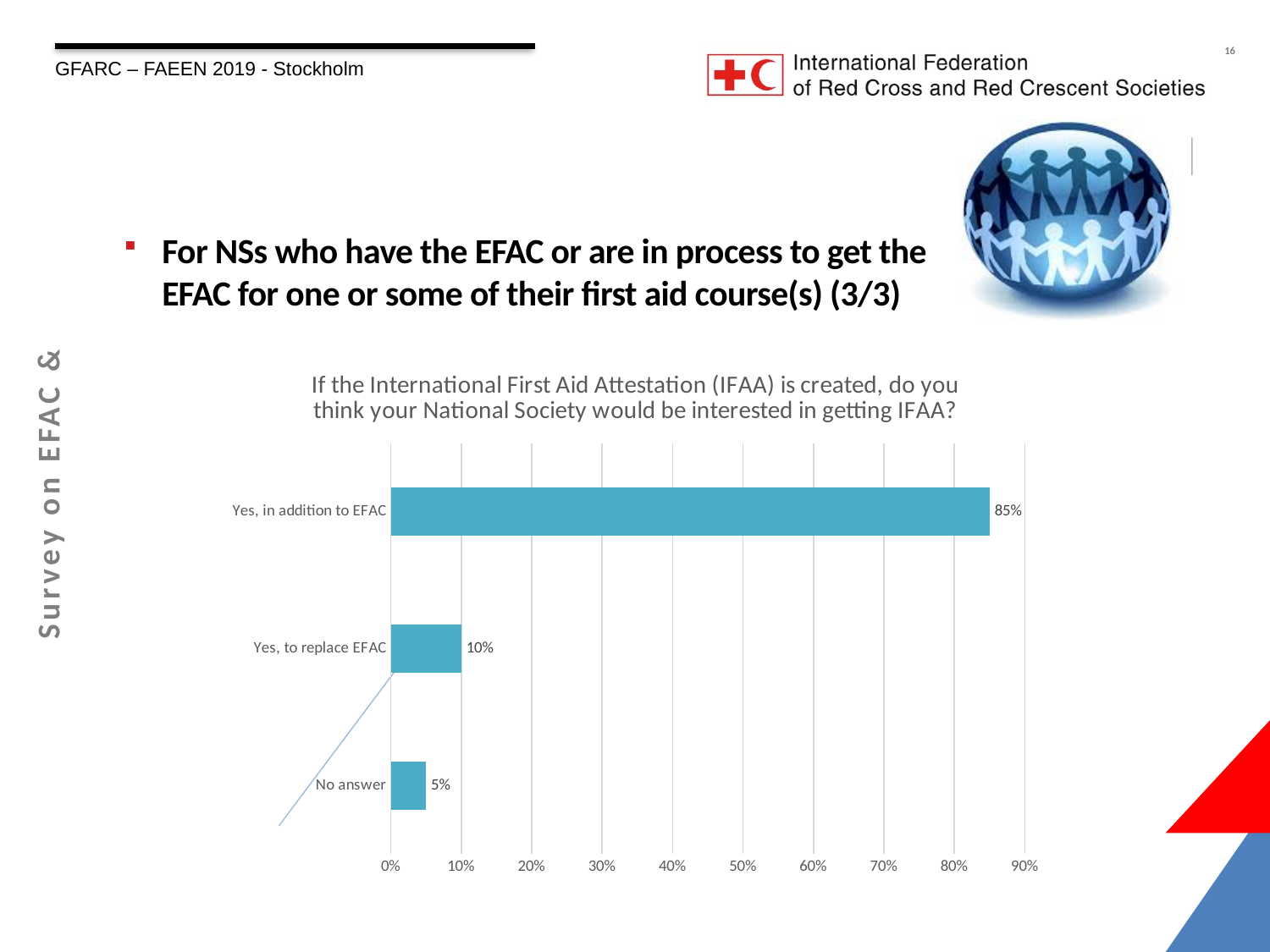
What is the difference between "Yes, in addition to EFAC" and "Yes, to replace EFAC"? 75% What is the value for "Yes, to replace EFAC"? 10% What is the value for "No answer"? 5% Which is larger: "Yes, to replace EFAC" or "No answer"? Yes, to replace EFAC What is the difference between "Yes, to replace EFAC" and "No answer"? 5% Is the value for "Yes, in addition to EFAC" greater or less than 80%? greater Which category has the lowest value? No answer What percentage of respondents answered "Yes, in addition to EFAC"? 85% What type of chart is shown on the slide? Bar chart Which category has the highest value? Yes, in addition to EFAC How many categories are shown in the chart? 3 What is the title of the chart? If the International First Aid Attestation (IFAA) is created, do you think your National Society would be interested in getting IFAA?